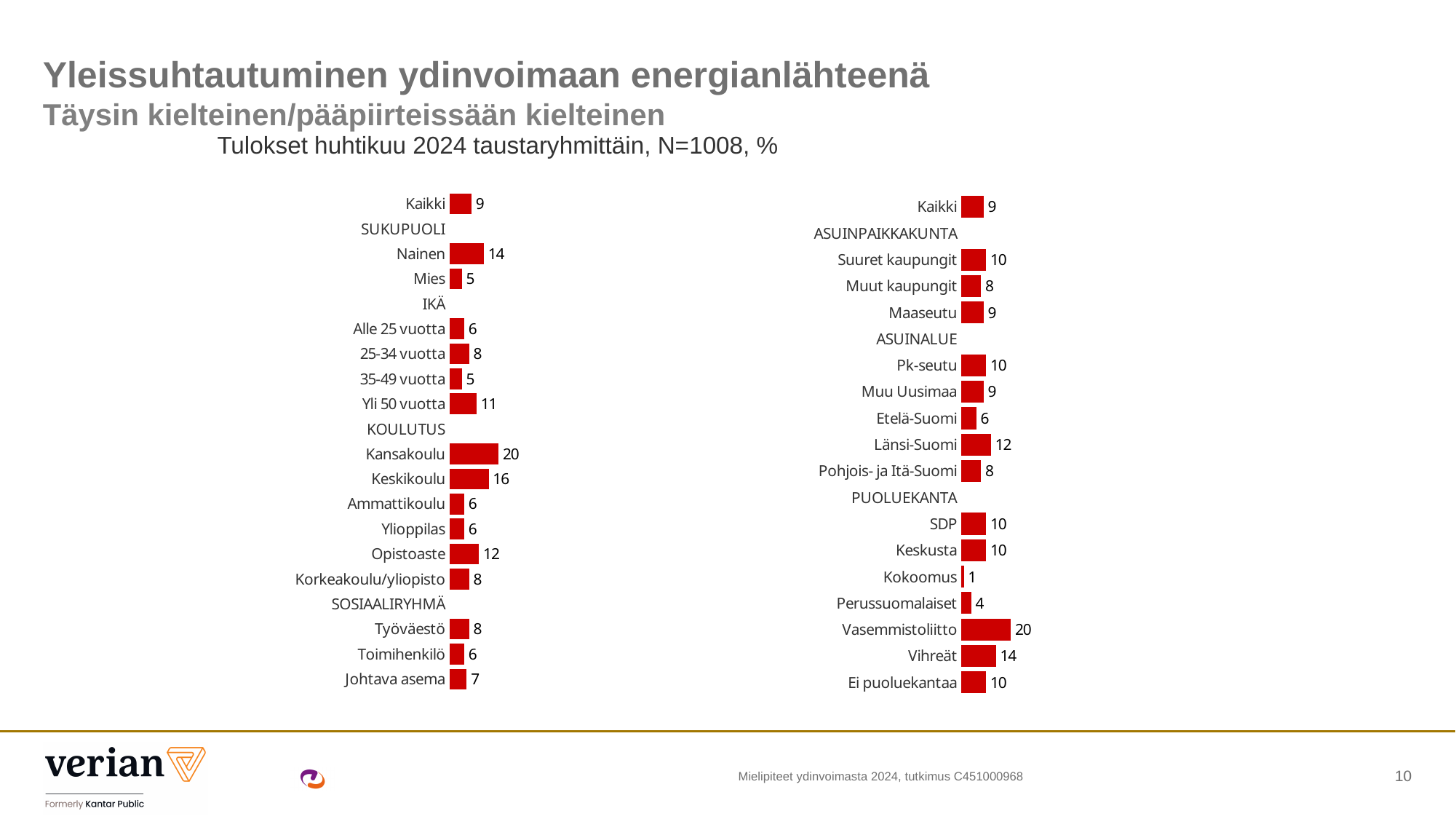
In the left chart, what is the difference between the values for Nainen and Mies? 9 In the left chart, what is the value for Nainen? 14 In the right chart, which category has the lowest value? Kokoomus In the left chart, which category has the highest value? Kansakoulu In the right chart, what is the value for Kokoomus? 1 In the right chart, which category has the highest value? Vasemmistoliitto In the right chart, what is the difference between the values for Vasemmistoliitto and Vihreät? 6 What kind of chart is shown on the left of the slide? Bar chart In the right chart, which is larger, the value for Perussuomalaiset or the value for SDP? SDP In the left chart, which is larger, the value for Yli 50 vuotta or the value for Alle 25 vuotta? Yli 50 vuotta In the right chart, what is the value for Länsi-Suomi? 12 In the left chart, what is the value for Kansakoulu? 20